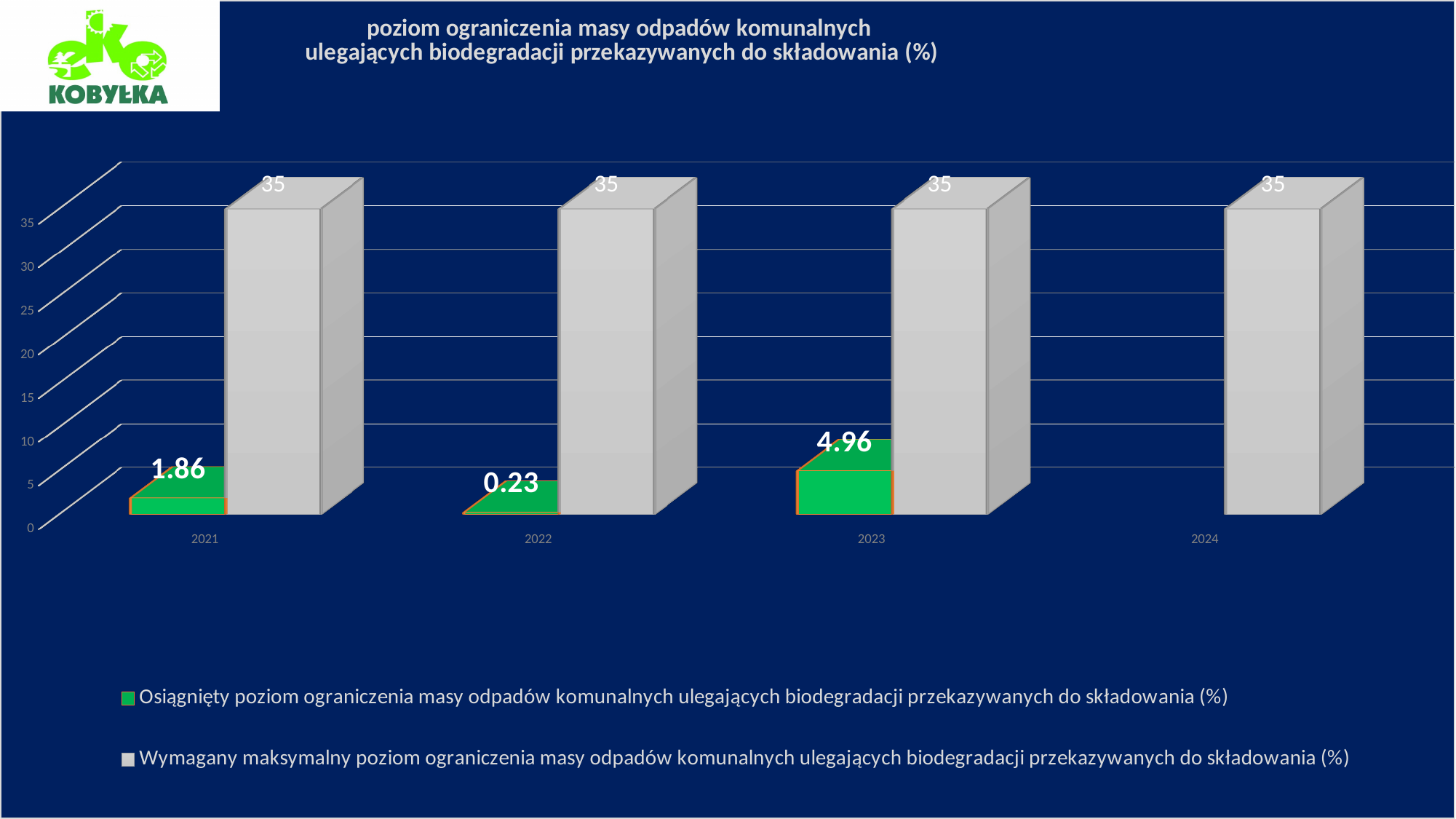
What is the required maximum level (Wymagany maksymalny poziom) for 2024? 35 In which year is the achieved level (green series) lowest? 2022 What kind of chart is shown on the slide? bar chart How many years are shown on the x axis? 4 In which year is the achieved level (green series) highest? 2023 What is the achieved level (Osiągnięty poziom) for 2023? 4.96 What is the achieved level (Osiągnięty poziom) for 2021? 1.86 What is the achieved level (Osiągnięty poziom) for 2022? 0.23 How many series does the legend list? 2 What is the difference between the required maximum level and the achieved level in 2023? 30.04 Which is larger in 2021: the achieved level or the required maximum level? the required maximum level Which colour represents the required maximum level series? grey